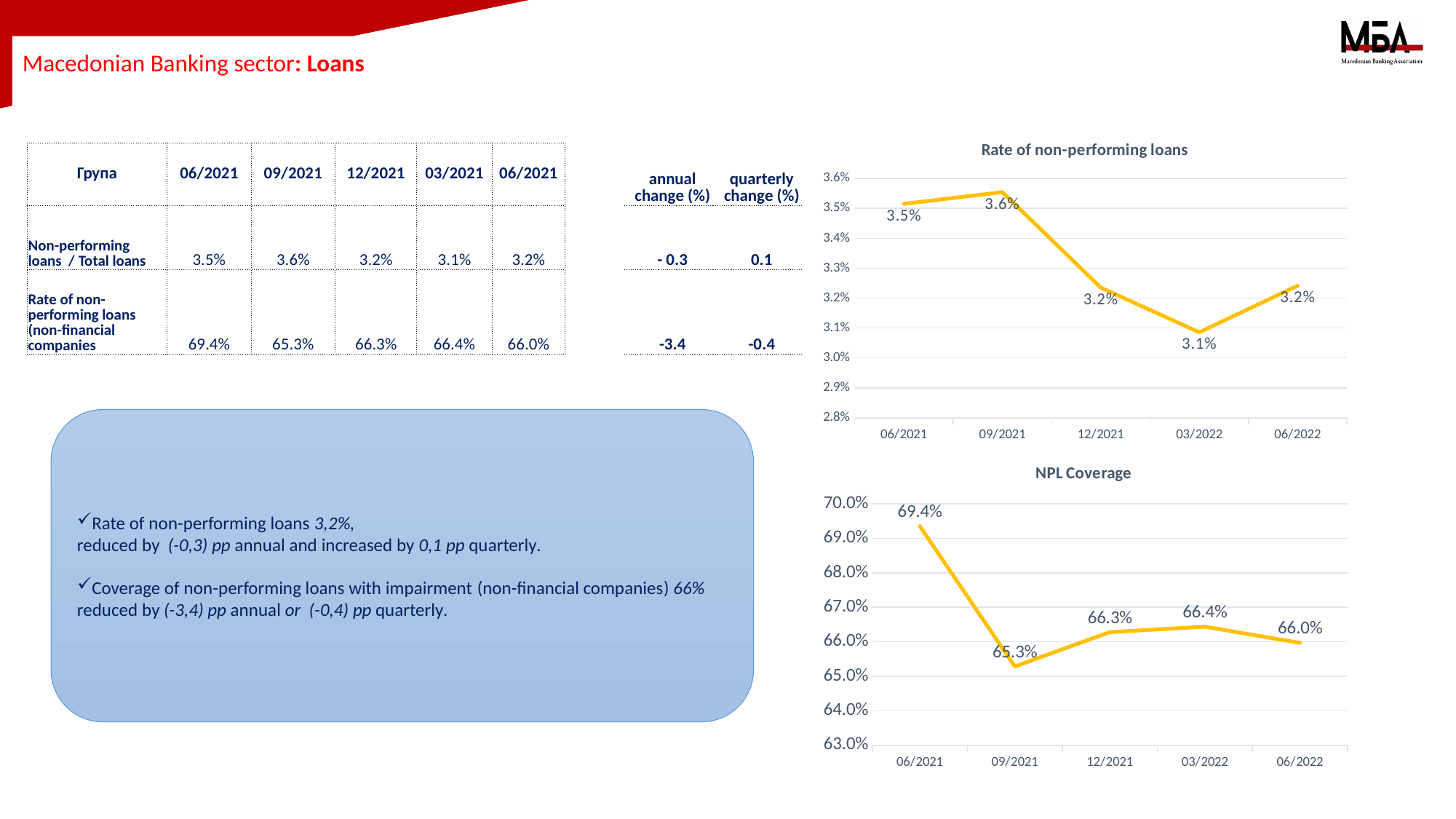
In the 'NPL Coverage' chart, what is the value for 06/2021? 69.4% In the 'NPL Coverage' chart, which period has the lowest value? 09/2021 In the 'Rate of non-performing loans' chart, how many data points are plotted? 5 In the 'NPL Coverage' chart, what is the value for 06/2022? 66.0% In the 'Rate of non-performing loans' chart, which period has the highest value? 09/2021 In the 'Rate of non-performing loans' chart, which period has the lowest value? 03/2022 What type of chart is the 'NPL Coverage' chart? Line chart In the 'NPL Coverage' chart, what is the difference between the 06/2021 value and the 09/2021 value? 4.1 percentage points In the 'Rate of non-performing loans' chart, what is the value for 03/2022? 3.1% In the 'Rate of non-performing loans' chart, what is the difference between the 09/2021 value and the 03/2022 value? 0.5 percentage points In the 'NPL Coverage' chart, is the value for 12/2021 larger or smaller than the value for 03/2022? Smaller In the 'Rate of non-performing loans' chart, what is the value for 09/2021? 3.6%